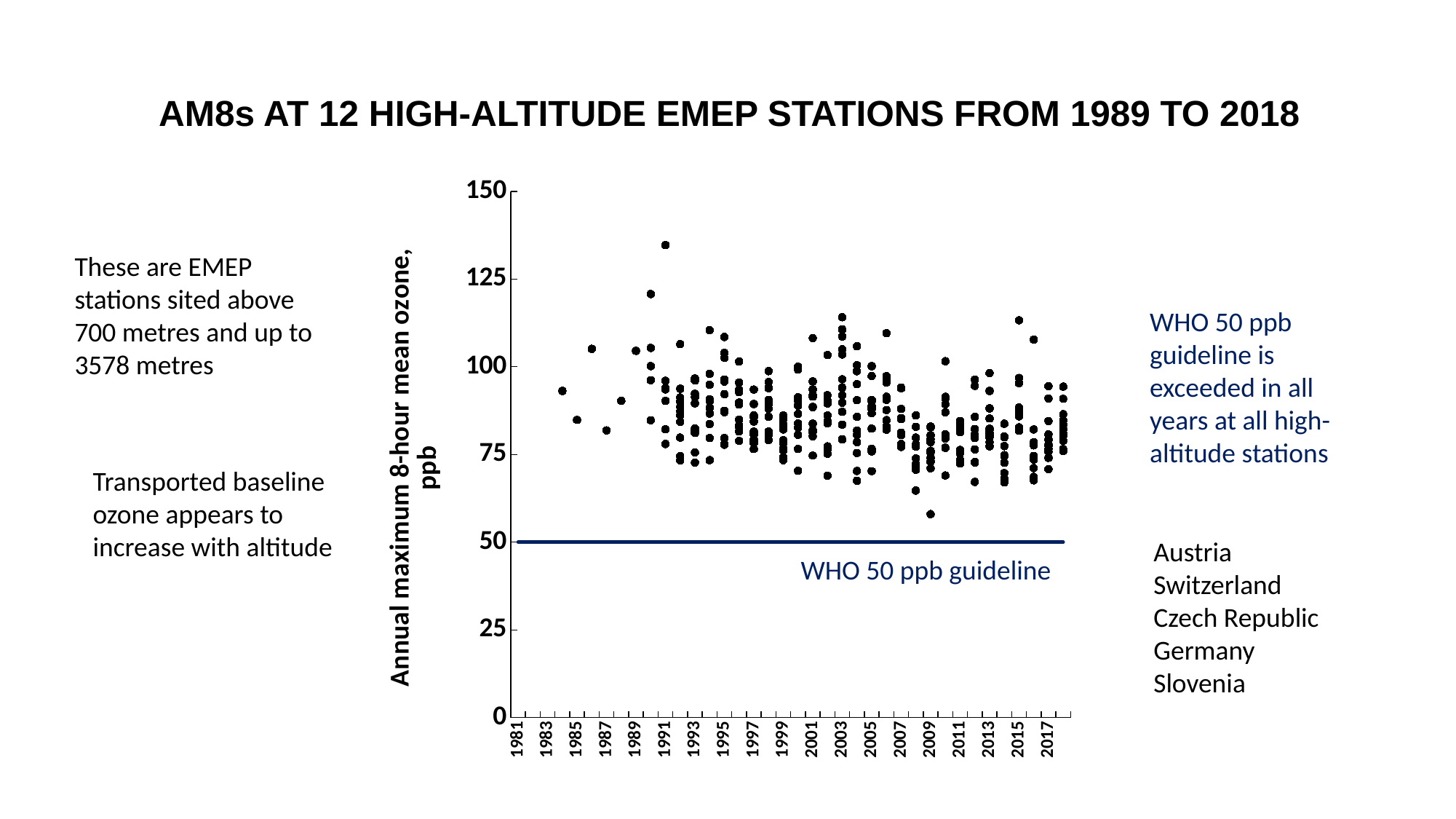
What is the title of the chart? AM8s AT 12 HIGH-ALTITUDE EMEP STATIONS FROM 1989 TO 2018 What is the maximum value shown on the vertical axis? 150 In which year does the highest plotted point occur? 1991 Is the highest plotted point greater or less than 125? greater Do any plotted points fall below the WHO 50 ppb guideline line? No In which year does the lowest plotted point occur? 2009 What kind of chart is shown on the slide? scatter plot Is the lowest plotted point greater or less than 50? greater What is the label of the vertical axis? Annual maximum 8-hour mean ozone, ppb At what value is the horizontal WHO guideline line drawn? 50 ppb